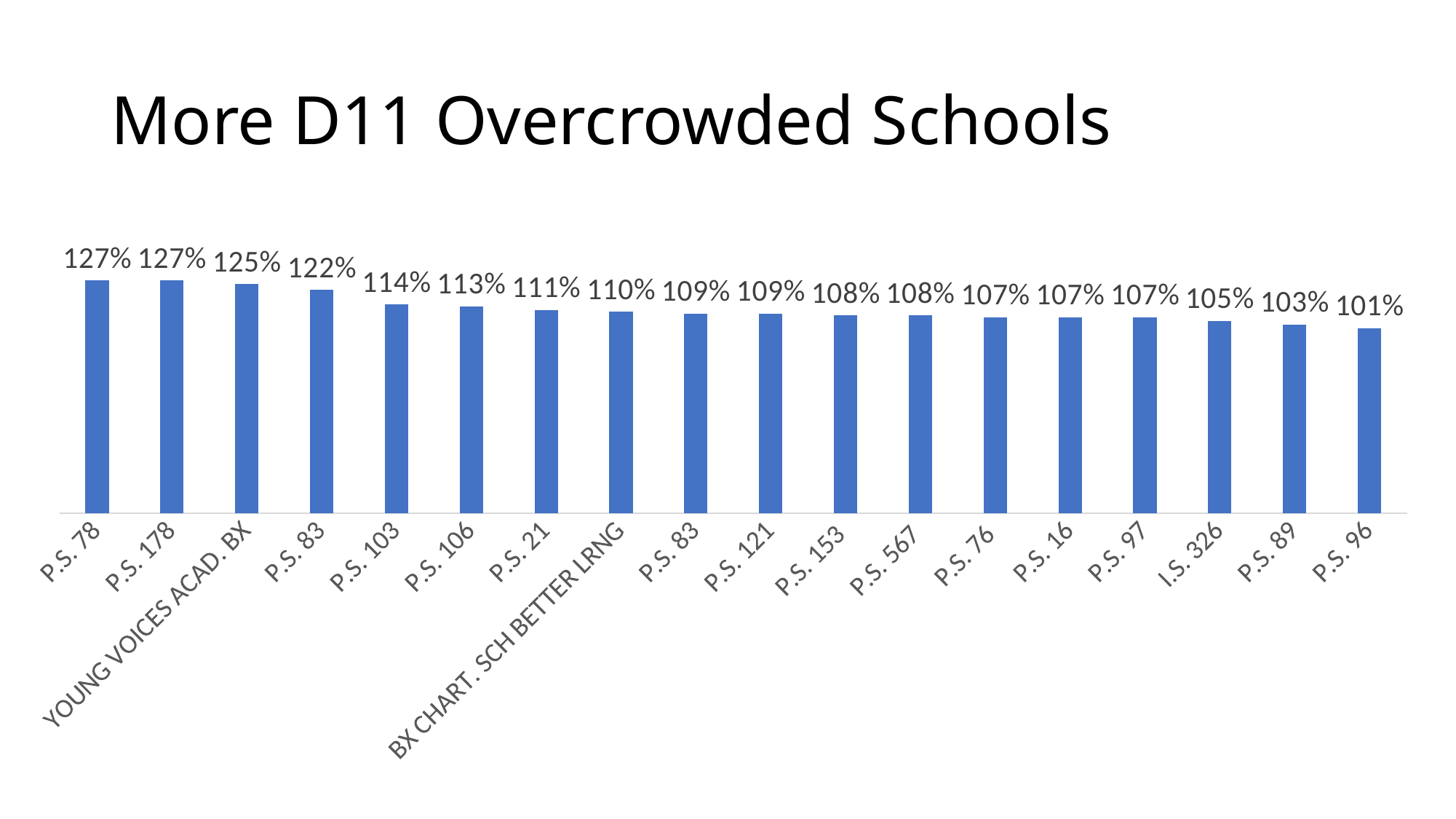
Which has a larger value, P.S. 21 or P.S. 153? P.S. 21 Do the values rise or fall from left to right along the x axis? fall What is the value for P.S. 103? 114% What is the value for P.S. 178? 127% How many schools are shown in the chart? 18 What kind of chart is shown on the slide? bar chart What is the difference between the values for P.S. 78 and P.S. 96? 26% What is the value for BX CHART. SCH BETTER LRNG? 110% What is the value for I.S. 326? 105% What is the difference between the values for P.S. 106 and P.S. 89? 10% What is the value for YOUNG VOICES ACAD. BX? 125% Which school has the lowest value? P.S. 96